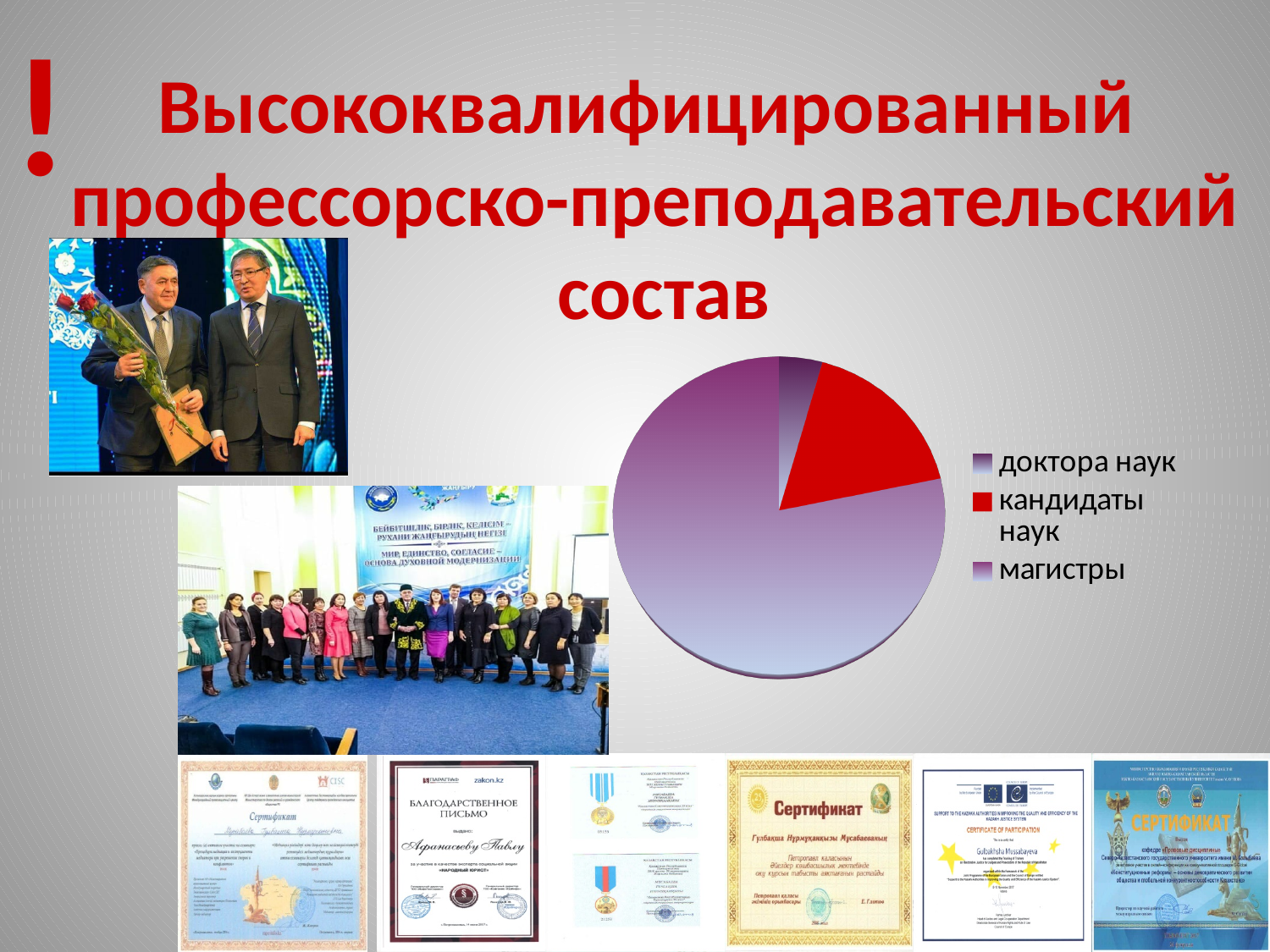
Which legend entry is listed first in the pie chart's legend? доктора наук Does the магистры slice make up more or less than half of the pie chart? more Which slice is larger in the pie chart: кандидаты наук or доктора наук? кандидаты наук Which slice is larger in the pie chart: магистры or кандидаты наук? магистры What kind of chart is shown on the slide? pie chart How many categories does the pie chart's legend list? 3 What colour is the кандидаты наук slice in the pie chart? red Which category has the smallest slice of the pie chart? доктора наук Which category has the largest slice of the pie chart? магистры